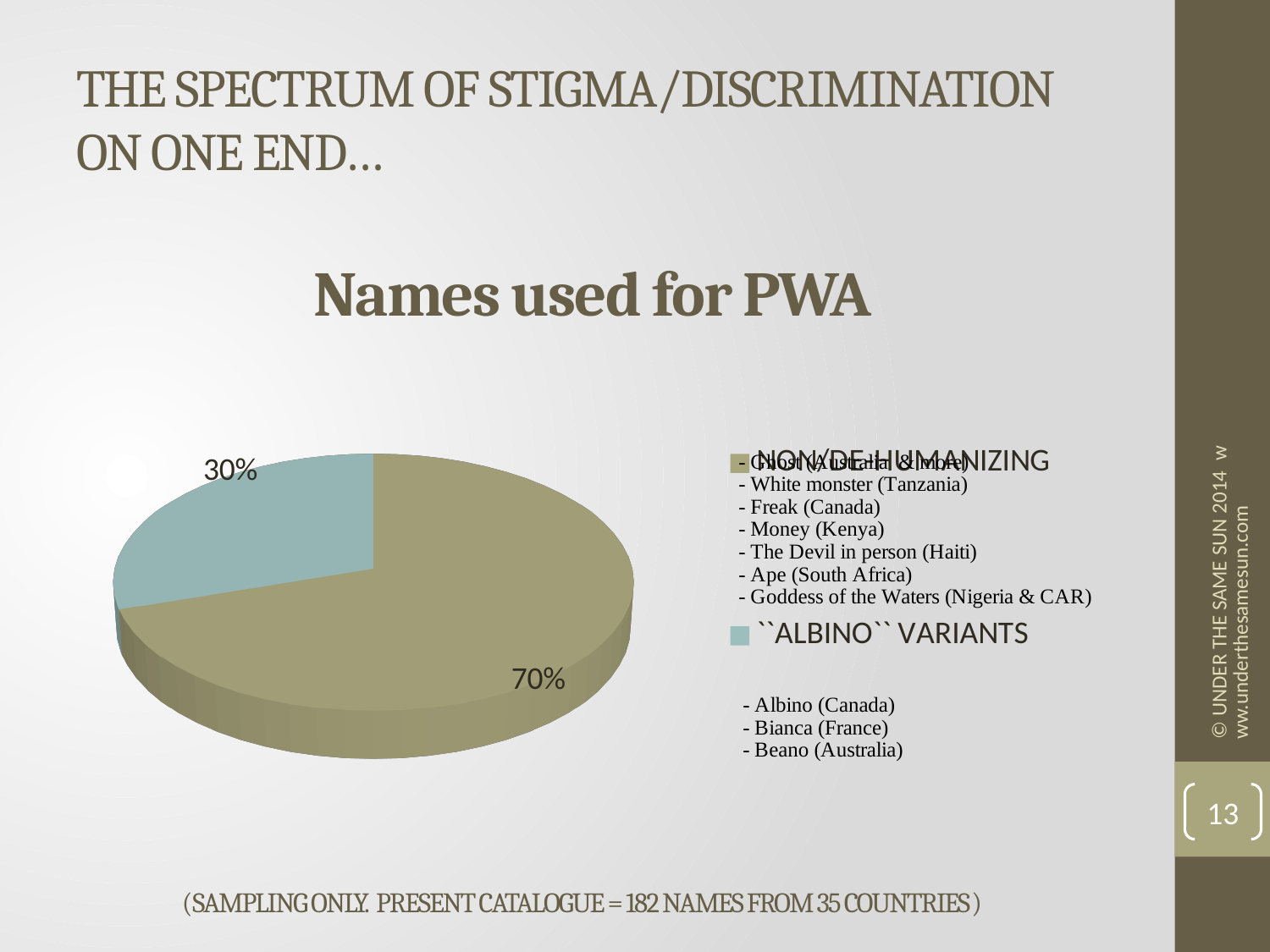
How many slices does the pie chart have? 2 Which is larger, the NON/DE-HUMANIZING slice or the ``ALBINO`` VARIANTS slice? NON/DE-HUMANIZING What kind of chart is shown on the slide? pie chart Which category has the smallest share of the pie? ``ALBINO`` VARIANTS What colour is the ``ALBINO`` VARIANTS slice? blue-grey Which category has the largest share of the pie? NON/DE-HUMANIZING What percentage of the pie is the NON/DE-HUMANIZING slice? 70% What is the total of the two slice percentages shown on the pie chart? 100% What is the title of the chart? Names used for PWA What percentage of the pie is the ``ALBINO`` VARIANTS slice? 30% What is the difference in percentage points between the NON/DE-HUMANIZING slice and the ``ALBINO`` VARIANTS slice? 40